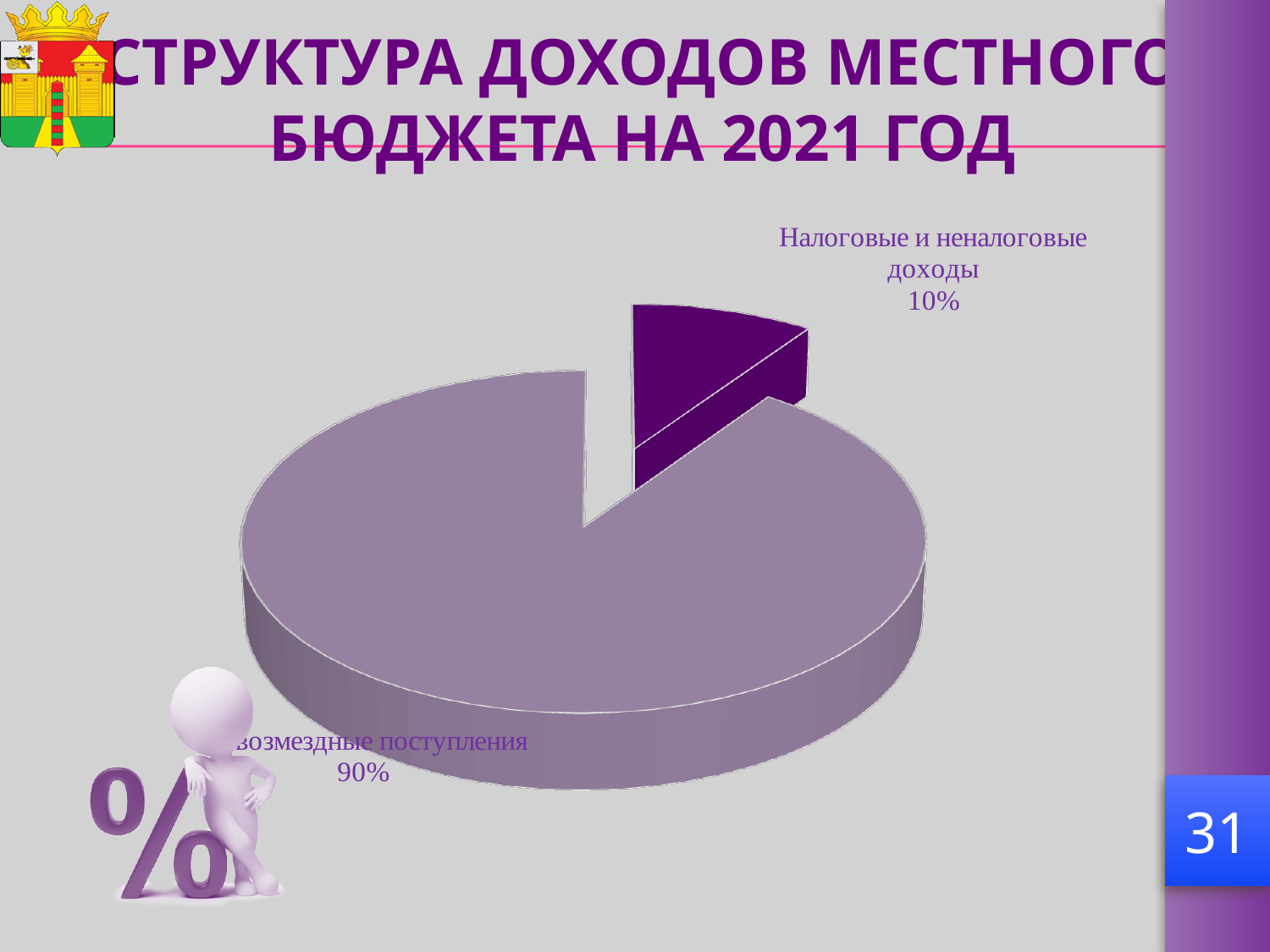
What share of the pie is labelled "Налоговые и неналоговые доходы"? 10% Which slice of the pie is the smallest? Налоговые и неналоговые доходы What is the title of the slide containing the pie chart? СТРУКТУРА ДОХОДОВ МЕСТНОГО БЮДЖЕТА НА 2021 ГОД What kind of chart is shown on the slide? Pie chart Which is larger: the share for "Налоговые и неналоговые доходы" or the share for "Безвозмездные поступления"? Безвозмездные поступления How many slices does the pie chart have? 2 What do the two slice percentages add up to? 100% What share of the pie is labelled "Безвозмездные поступления"? 90% By how many percentage points does "Безвозмездные поступления" exceed "Налоговые и неналоговые доходы"? 80 percentage points Which slice of the pie is the largest? Безвозмездные поступления What colour is the slice for "Налоговые и неналоговые доходы"? Dark purple